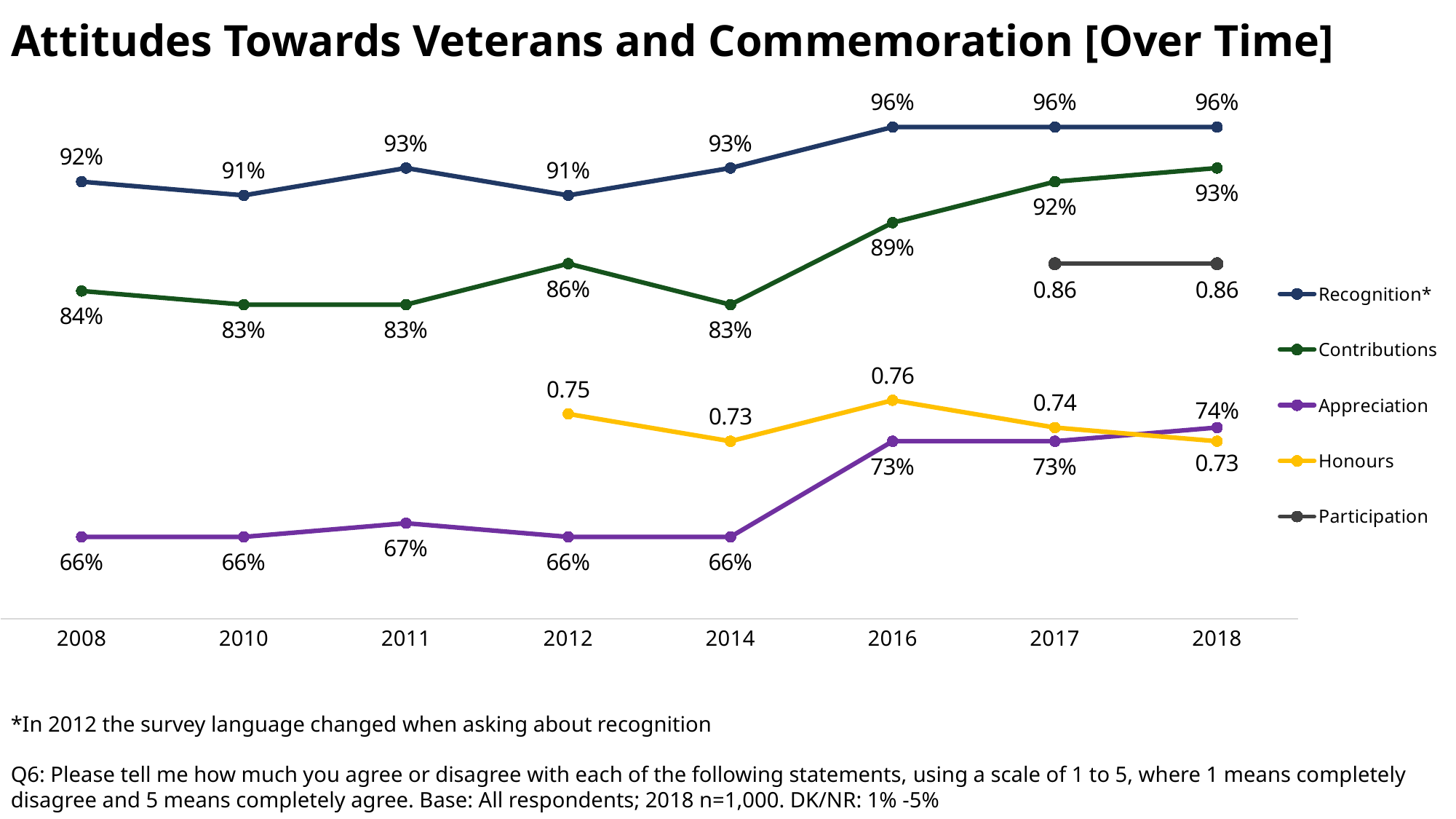
What is the difference between the Recognition* value and the Contributions value in 2018? 3 percentage points Does the Contributions series rise or fall from 2014 to 2018? Rise In which year is the Honours series at its highest? 2016 Which is larger in 2014, the Recognition* value or the Contributions value? Recognition* What is the value for Contributions in 2016? 89% What is the value for Honours in 2016? 0.76 What kind of chart is shown on the slide? Line chart How many years are shown on the x axis? 8 How many series does the legend list? 5 In which year is the Contributions series at its highest? 2018 What is the value for Recognition* in 2008? 92% What is the value for Participation in 2017? 0.86